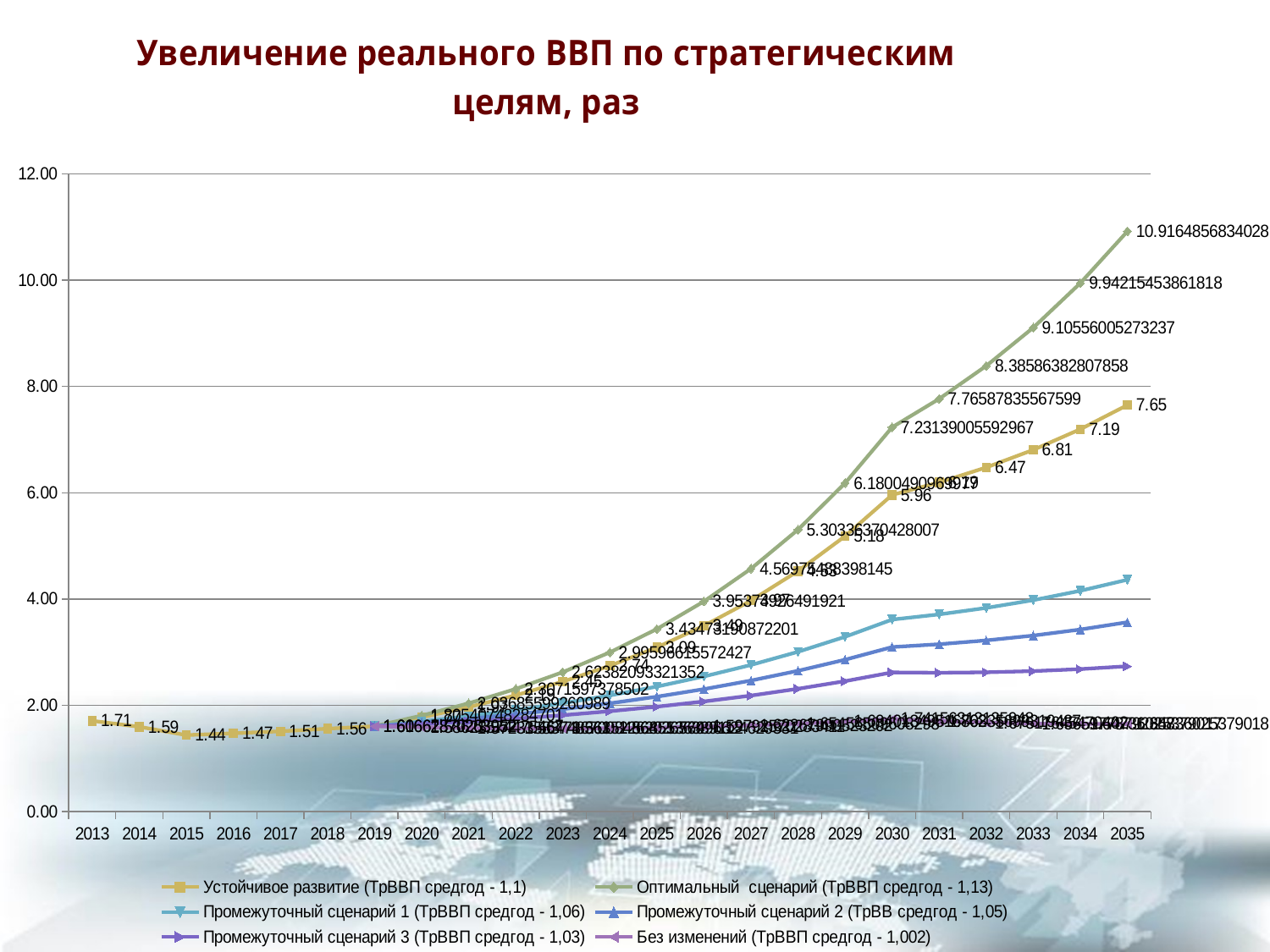
What is the value of the Оптимальный сценарий series in 2035? 10.9164856834028 Which is larger in 2034: the Оптимальный сценарий value or the Устойчивое развитие value? Оптимальный сценарий How many series does the legend list? 6 Which series has the highest value in 2035? Оптимальный сценарий (ТрВВП средгод - 1,13) Does the Оптимальный сценарий series rise or fall from 2020 to 2035? rise What is the value of the Устойчивое развитие series in 2035? 7.65 What kind of chart is shown on the slide? line chart Is the value of Промежуточный сценарий 1 in 2035 greater or less than 4.00? greater How many years are shown on the x axis? 23 What is the value of the Устойчивое развитие series in 2013? 1.71 In which year does the Устойчивое развитие series reach its lowest value? 2015 What is the difference between the Устойчивое развитие values in 2035 and 2034? 0.46